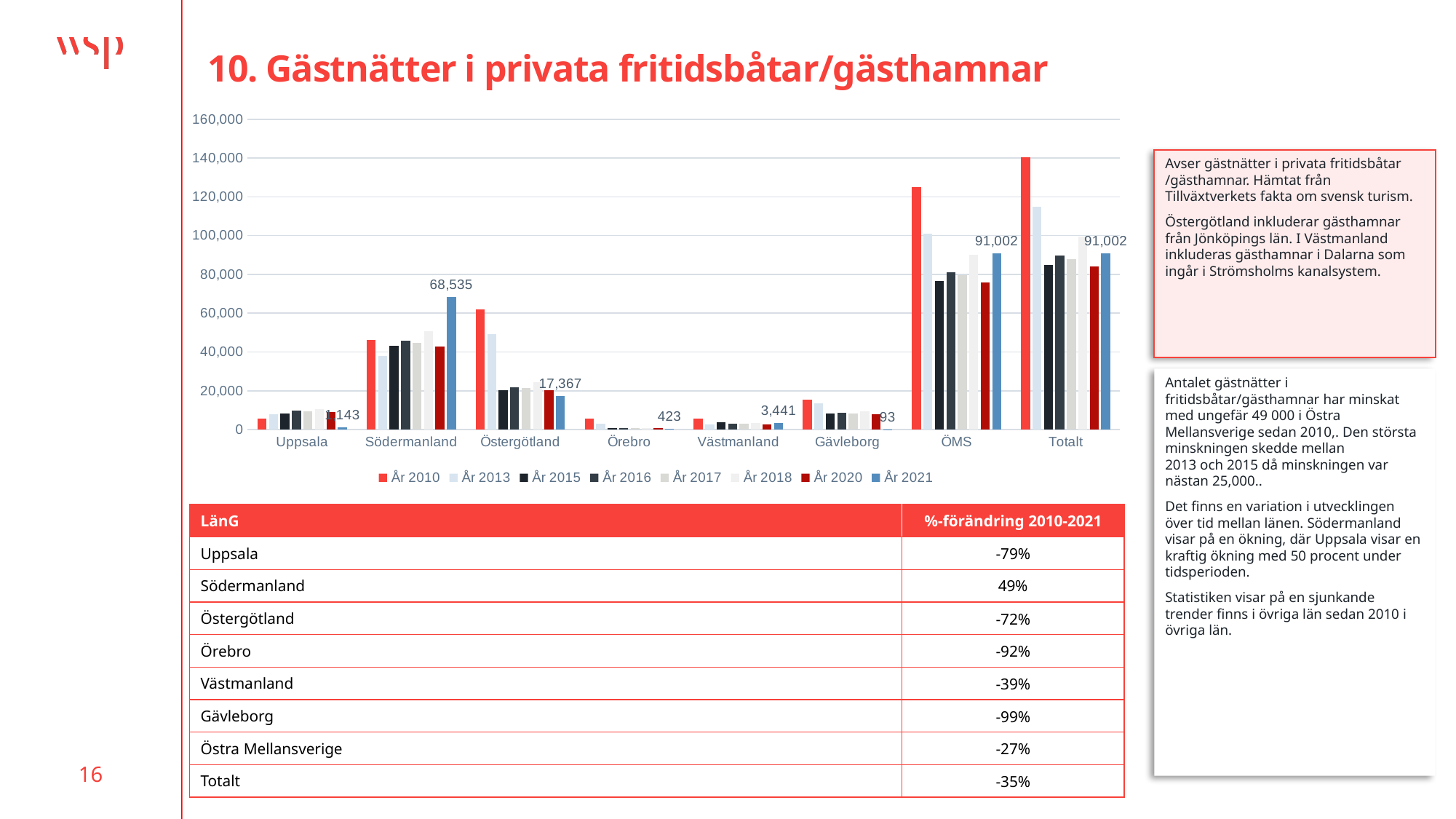
What kind of chart is shown on the slide? bar chart What is the År 2021 value for Gävleborg? 93 What is the År 2021 value for Västmanland? 3,441 What is the År 2021 value for Södermanland? 68,535 How many categories are shown along the x axis of the chart? 8 What is the År 2021 value for ÖMS? 91,002 How many series does the chart legend list? 8 What is the År 2021 value for Örebro? 423 What is the difference between the År 2021 values for Södermanland and Östergötland? 51,168 Is the År 2010 value for Totalt greater or less than 120,000? greater For Södermanland, which is larger: the År 2010 value or the År 2021 value? År 2021 What is the År 2021 value for Östergötland? 17,367